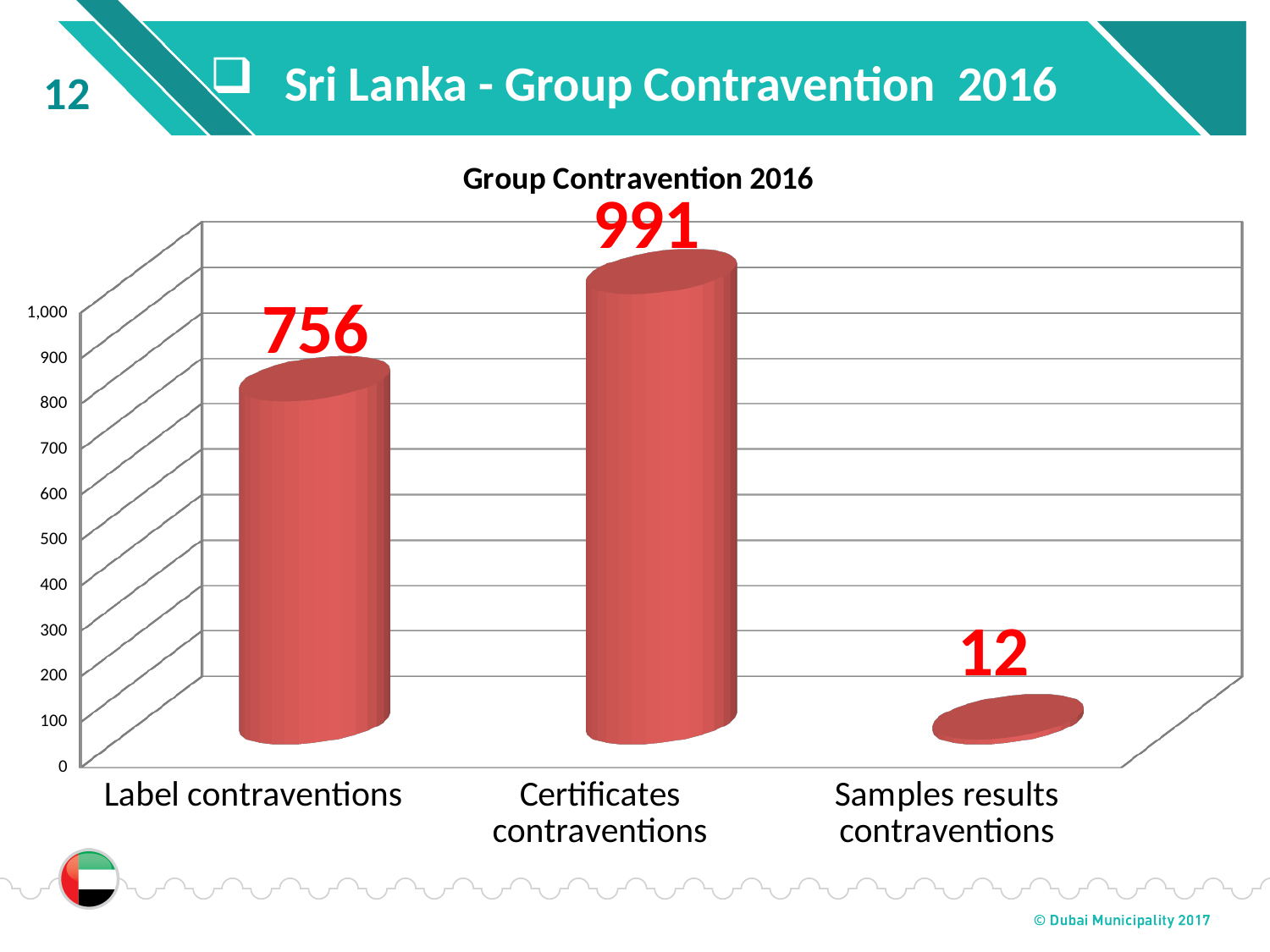
How many categories are shown in the chart? 3 What is the difference between Certificates contraventions and Label contraventions? 235 What is the title of the chart? Group Contravention 2016 What is the difference between Label contraventions and Samples results contraventions? 744 Which category has the highest value? Certificates contraventions What kind of chart is shown on the slide? bar chart Is the value for Label contraventions greater or less than 800? less Which category has the lowest value? Samples results contraventions What is the value for Samples results contraventions? 12 What is the value for Certificates contraventions? 991 What is the value for Label contraventions? 756 Which is larger, Label contraventions or Certificates contraventions? Certificates contraventions